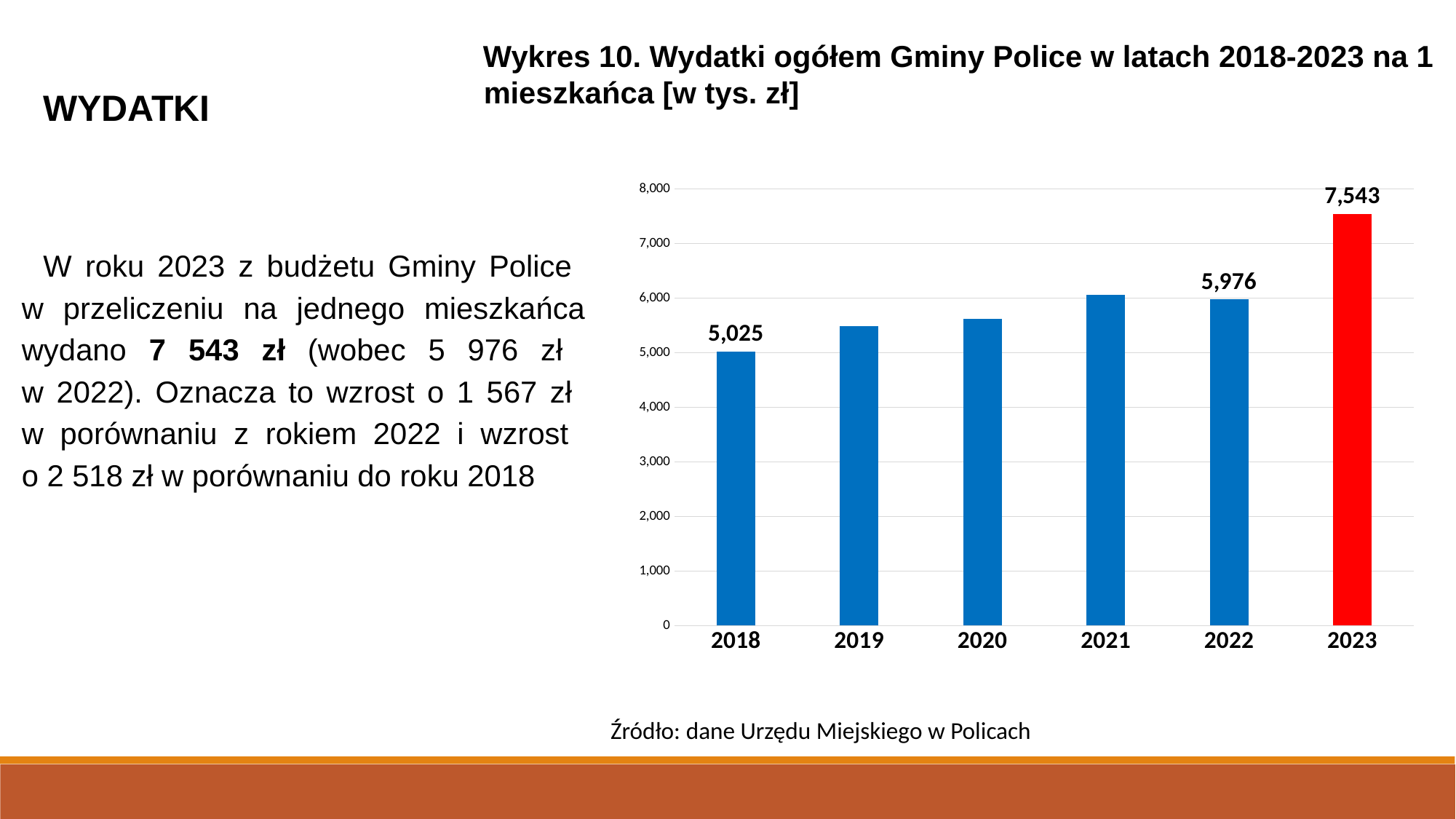
Which is larger, the value for 2021 or the value for 2019? 2021 Which year has the highest value? 2023 Is the value for 2019 greater or less than 6,000? less What is the value for 2023? 7,543 What kind of chart is this? bar chart How many years are shown on the x axis? 6 What is the value for 2022? 5,976 Is the value for 2021 greater or less than 7,000? less What is the value for 2018? 5,025 What is the difference between the values for 2023 and 2022? 1,567 Which year has the lowest value? 2018 What is the difference between the values for 2023 and 2018? 2,518